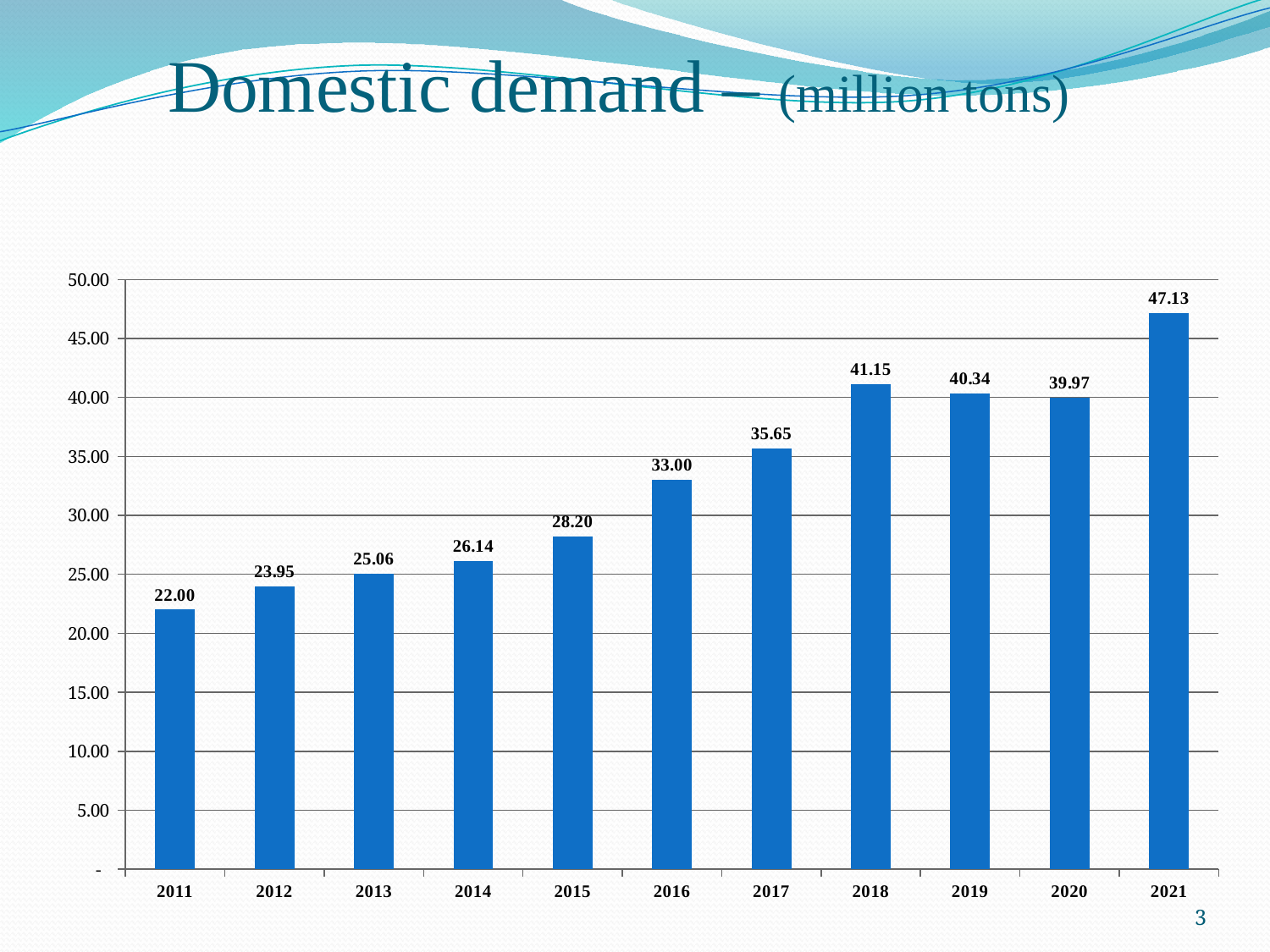
Which year has the highest domestic demand? 2021 Is the value for 2016 greater or less than 30.00? greater Does domestic demand generally rise or fall from 2011 to 2021? Rise Which year has the lowest domestic demand? 2011 What unit is given in the slide title for domestic demand? million tons What is the difference between the domestic demand in 2021 and in 2011? 25.13 What is the domestic demand value for 2015? 28.20 What is the domestic demand value for 2019? 40.34 How many years are shown on the x axis of the chart? 11 Which year has a larger domestic demand, 2019 or 2020? 2019 What is the difference between the domestic demand in 2018 and in 2017? 5.50 What kind of chart is shown on the slide? Bar chart